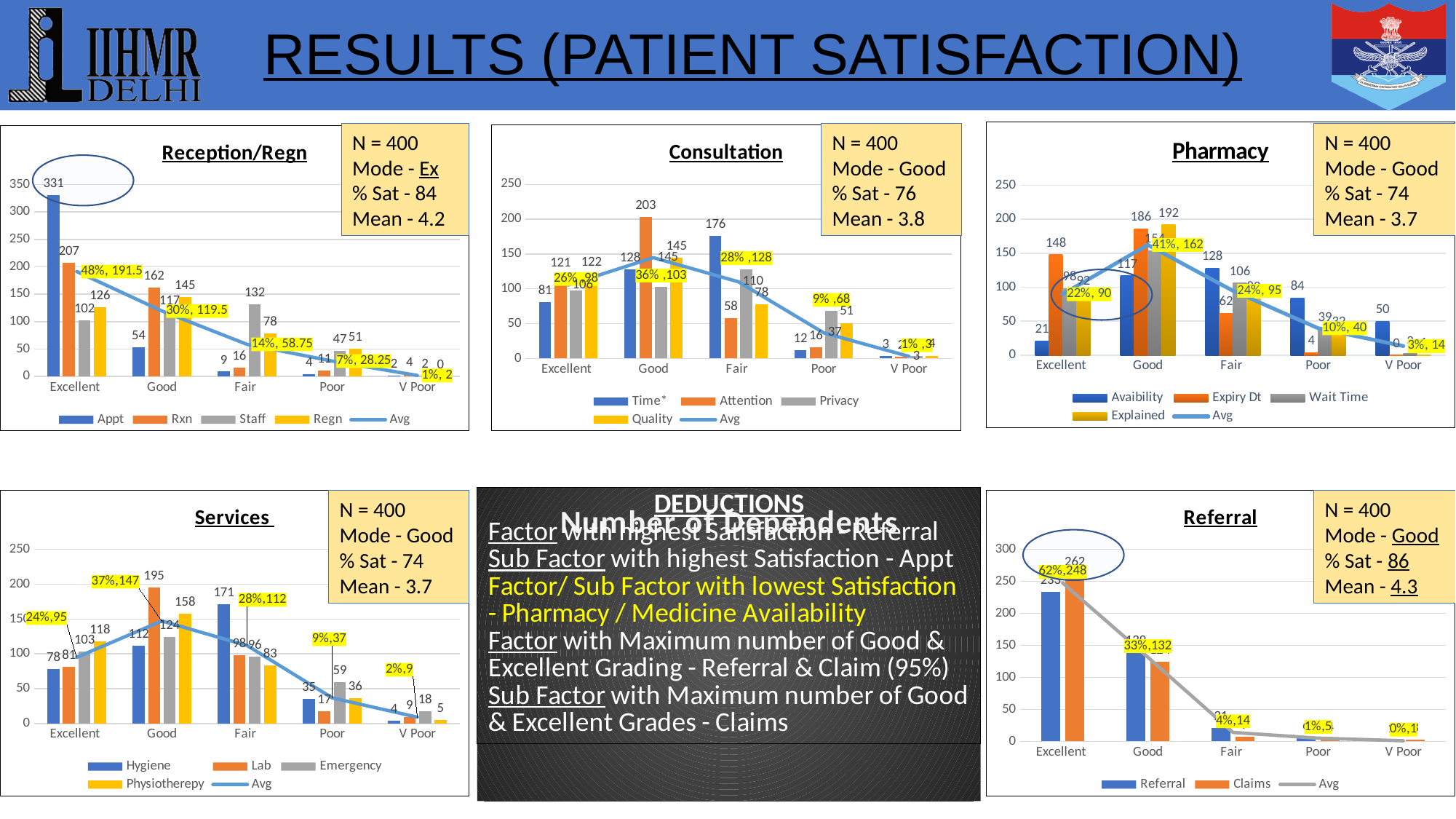
In the Pharmacy chart, which is larger for Avaibility: the Excellent value or the Poor value? Poor How many series does the legend of the Reception/Regn chart list? 5 In the Referral chart, what is the value for Claims in the Excellent category? 262 In the Pharmacy chart, what is the value for Expiry Dt in the Good category? 186 In the Services chart, what is the value for Lab in the Good category? 195 In the Services chart, how many categories are shown on the x axis? 5 In the Services chart, what is the difference between the Lab and Hygiene values in the Good category? 83 In the Reception/Regn chart, what is the value for Appt in the Excellent category? 331 In the Reception/Regn chart, which category has the highest Appt value? Excellent In the Consultation chart, what is the value for Time* in the Fair category? 176 In the Referral chart, does the Avg line rise or fall from Excellent to V Poor? fall In the Consultation chart, what is the value for Attention in the Good category? 203